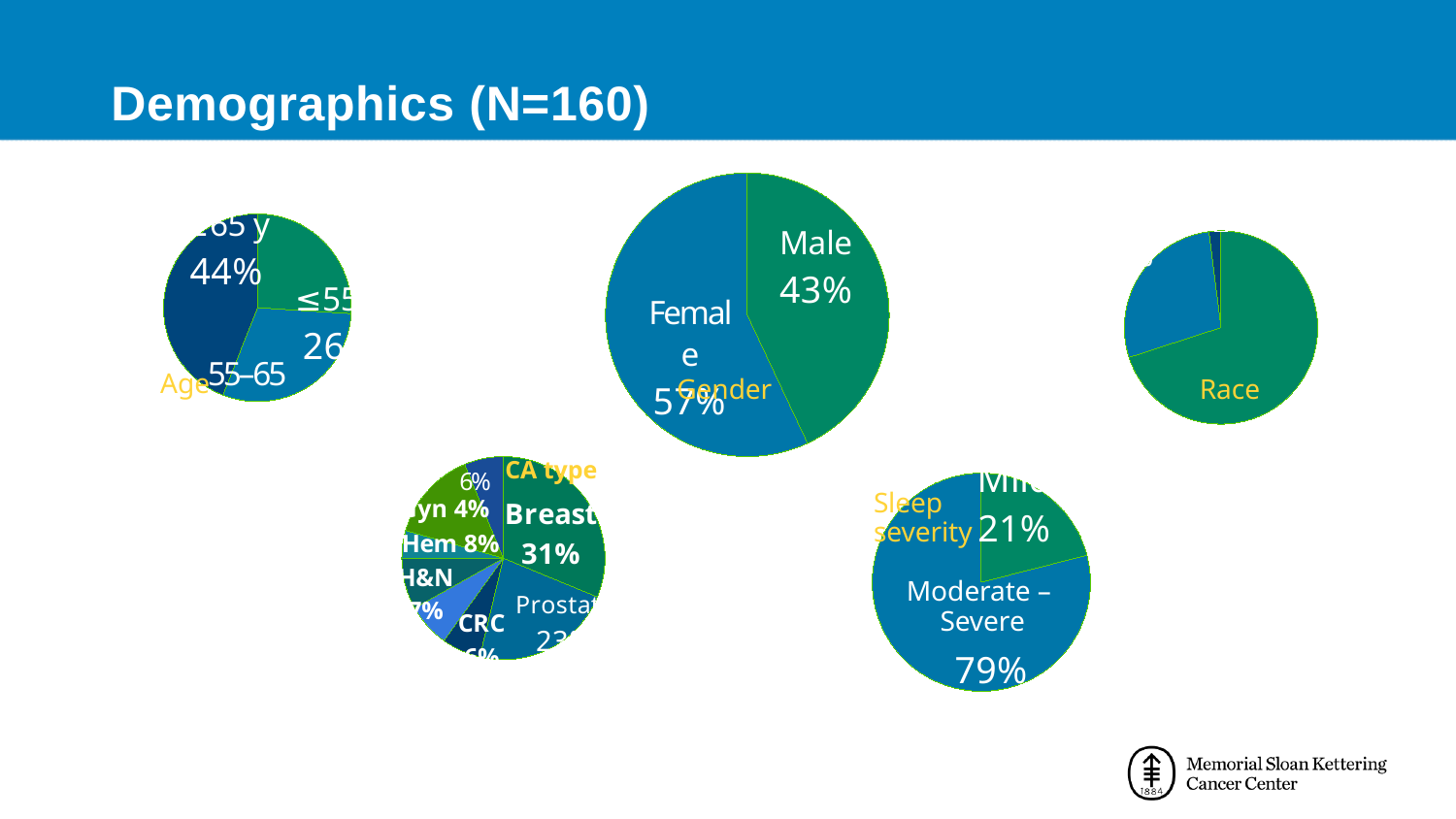
In the Sleep severity pie chart, what percentage is Moderate – Severe? 79% In the Gender pie chart, what percentage is Male? 43% What kind of chart is used for Race on this slide? Pie chart In the Gender pie chart, which slice is larger, Male or Female? Female In the Sleep severity pie chart, what percentage is Mild? 21% In the Gender pie chart, what is the difference between the Female and Male percentages? 14% How many pie charts are shown on the slide? 5 In the Age pie chart, what percentage is ≥65 y? 44% In the CA type pie chart, what percentage is Breast? 31% In the Sleep severity pie chart, which category has the largest share? Moderate – Severe In the CA type pie chart, what percentage is Hem? 8% In the Gender pie chart, what percentage is Female? 57%